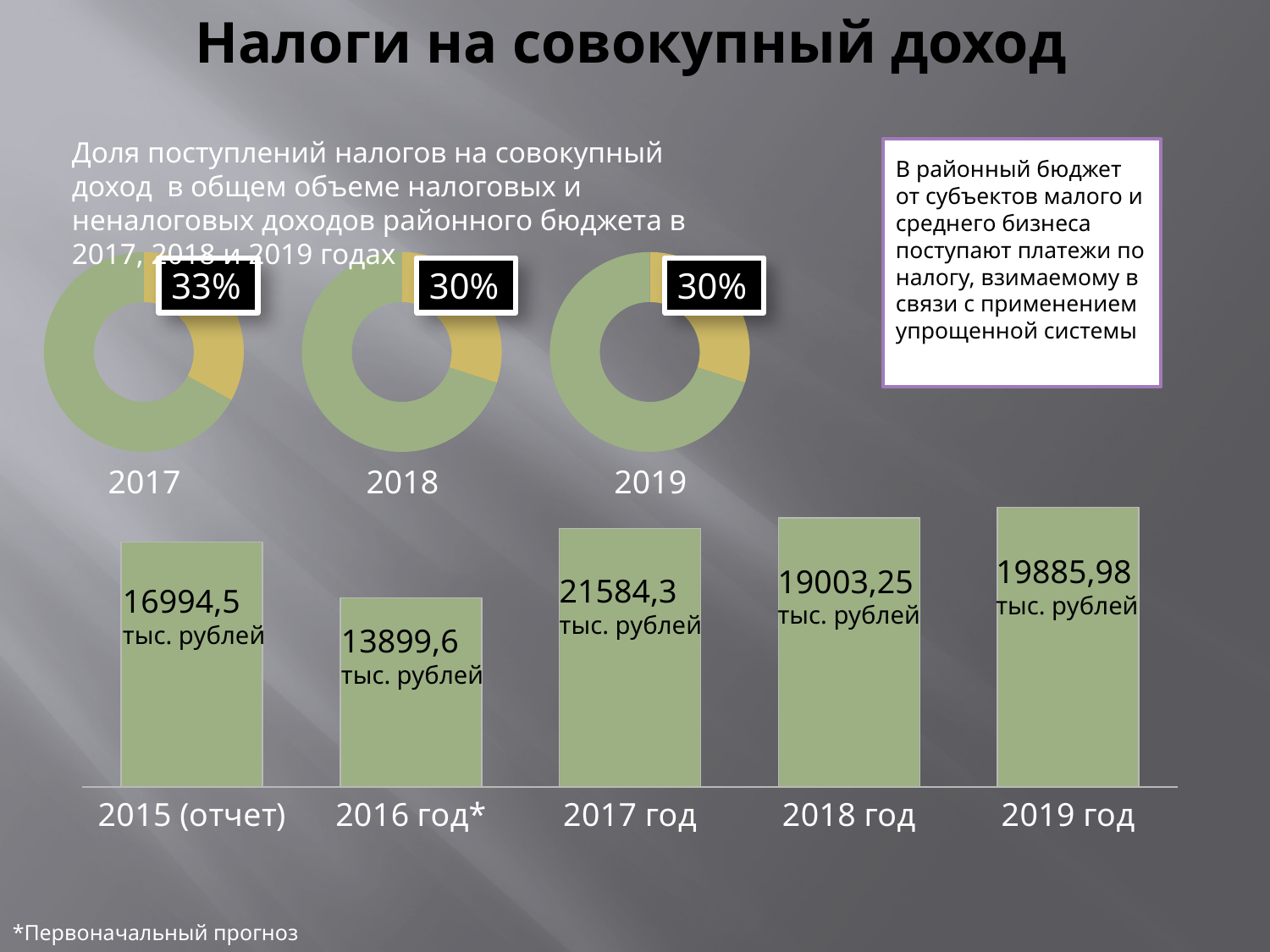
In the bar chart at the bottom, which is larger: the value for 2015 (отчет) or the value for 2018 год? 2018 год In the bar chart at the bottom, which year has the lowest value? 2016 год* In the bar chart at the bottom, what is the difference between the values for 2019 год and 2018 год? 882,73 тыс. рублей In the bar chart at the bottom, what is the value for 2019 год? 19885,98 тыс. рублей In the bar chart at the bottom, what is the value for 2016 год*? 13899,6 тыс. рублей In the bar chart at the bottom, what is the difference between the values for 2017 год and 2016 год*? 7684,7 тыс. рублей In the donut chart labelled 2017, what share is shown by the highlighted slice? 33% In the donut chart labelled 2019, what share is shown by the highlighted slice? 30% In the bar chart at the bottom, what is the value for 2017 год? 21584,3 тыс. рублей What kind of chart is shown at the bottom of the slide? bar chart In the bar chart at the bottom, which year has the highest value? 2017 год How many bars does the bar chart at the bottom of the slide have? 5